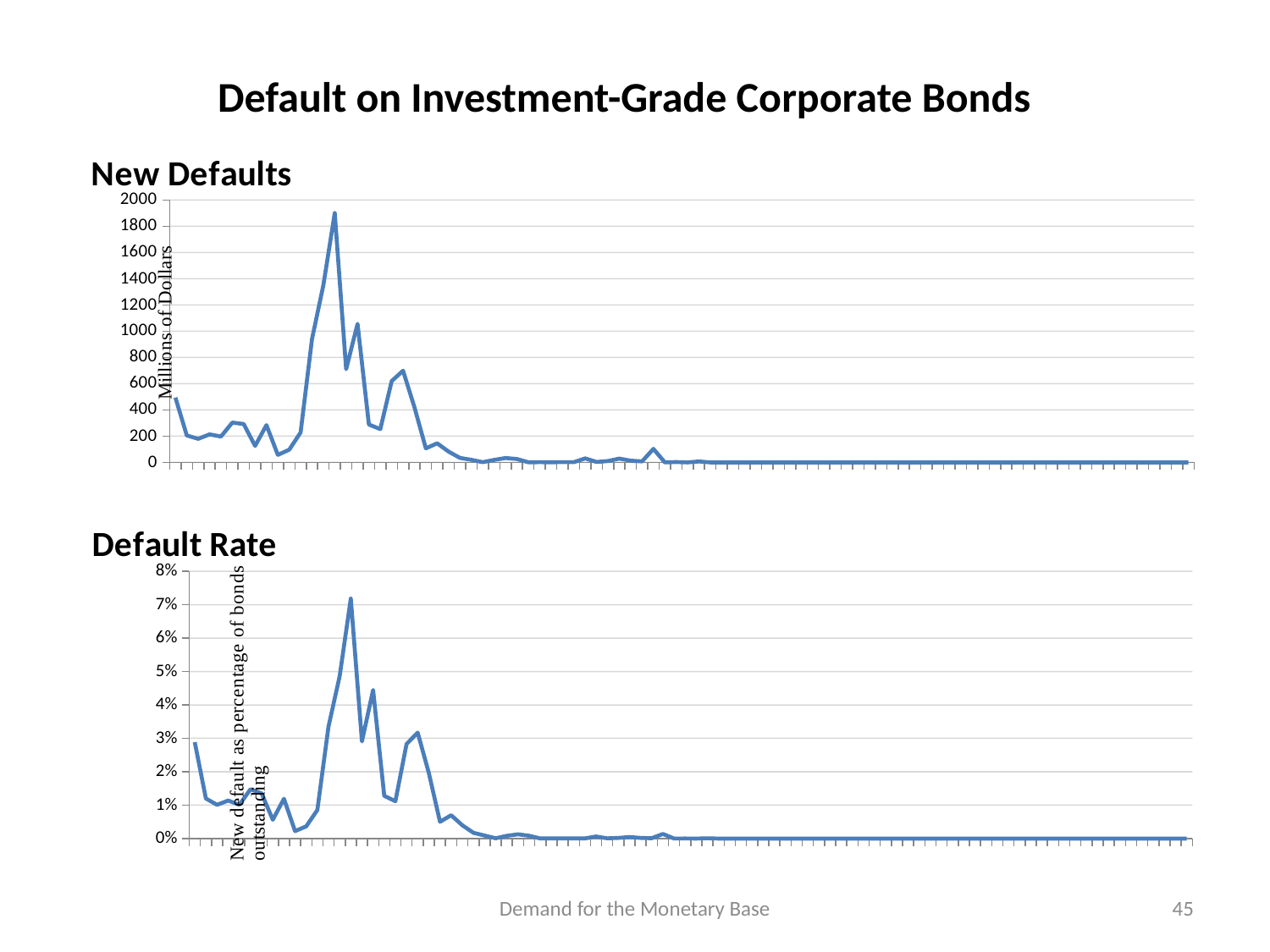
In the New Defaults chart, after the peak, do the values generally rise or fall toward the right end of the x axis? fall What is the highest tick value shown on the vertical axis of the Default Rate chart? 8% In the New Defaults chart, do the values in the right half of the chart stay above or below 200? below In the Default Rate chart, what is the label on the vertical axis? New default as percentage of bonds outstanding In the Default Rate chart, after the peak, do the values generally rise or fall toward the right end of the x axis? fall What kind of chart is the New Defaults chart? line chart In the New Defaults chart, is the first plotted value greater or less than 400? greater In the Default Rate chart, is the first plotted value greater or less than 2%? greater What kind of chart is the Default Rate chart? line chart In the New Defaults chart, what is the label on the vertical axis? Millions of Dollars